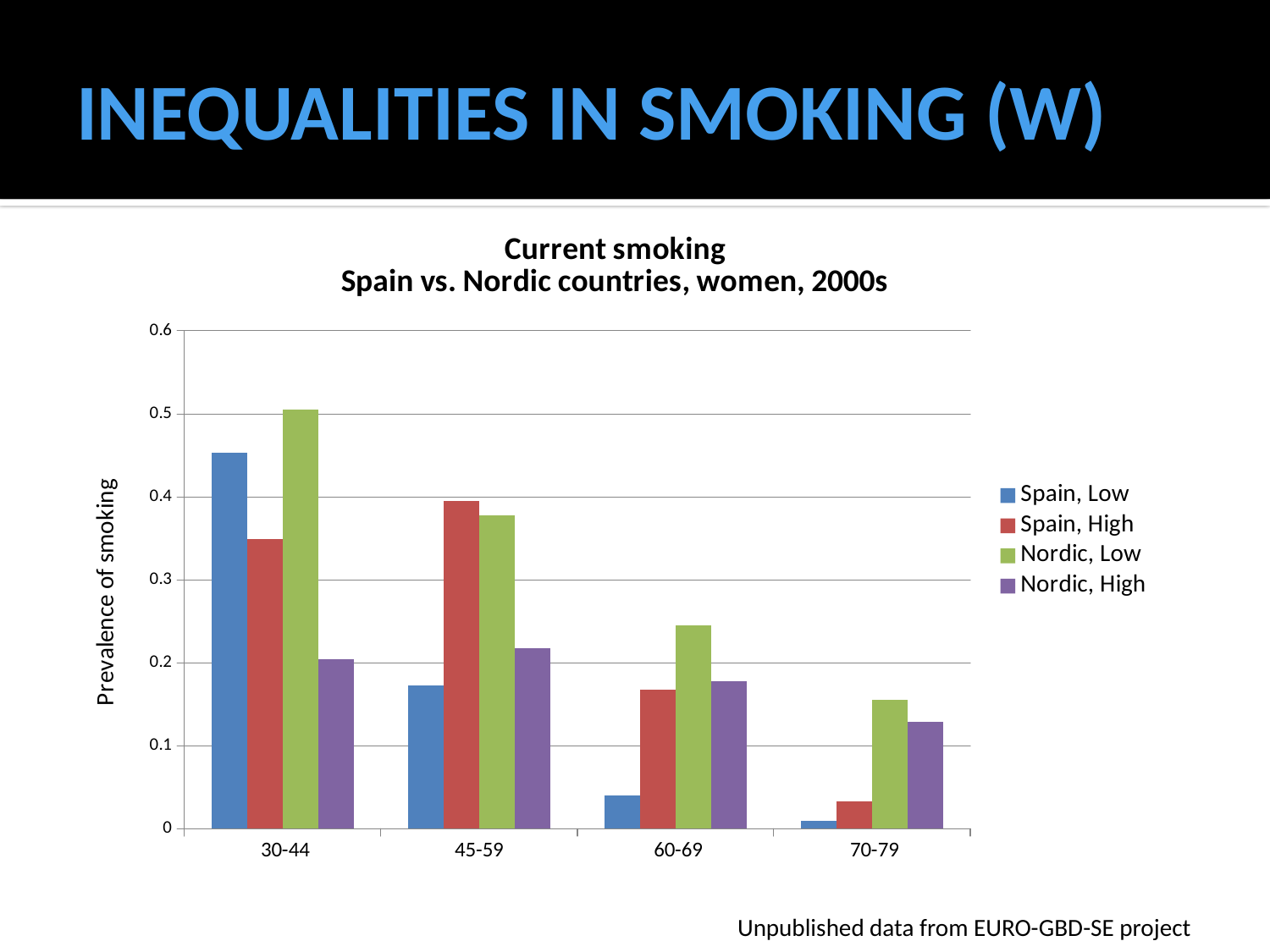
Is the value for Spain, Low in the 30-44 age group greater or less than 0.4? greater How many age groups are shown on the x axis? 4 Is the value for Nordic, High in the 30-44 age group greater or less than 0.3? less How many series does the legend list? 4 Which series has the lowest bar in the 70-79 age group? Spain, Low Which is larger in the 30-44 age group, Spain, Low or Spain, High? Spain, Low Do the values for Spain, Low rise or fall as the age groups increase along the x axis? fall What is the label of the y axis? Prevalence of smoking Is the value for Spain, High in the 45-59 age group greater or less than 0.3? greater What kind of chart is shown on the slide? bar chart Which series has the highest bar in the 30-44 age group? Nordic, Low